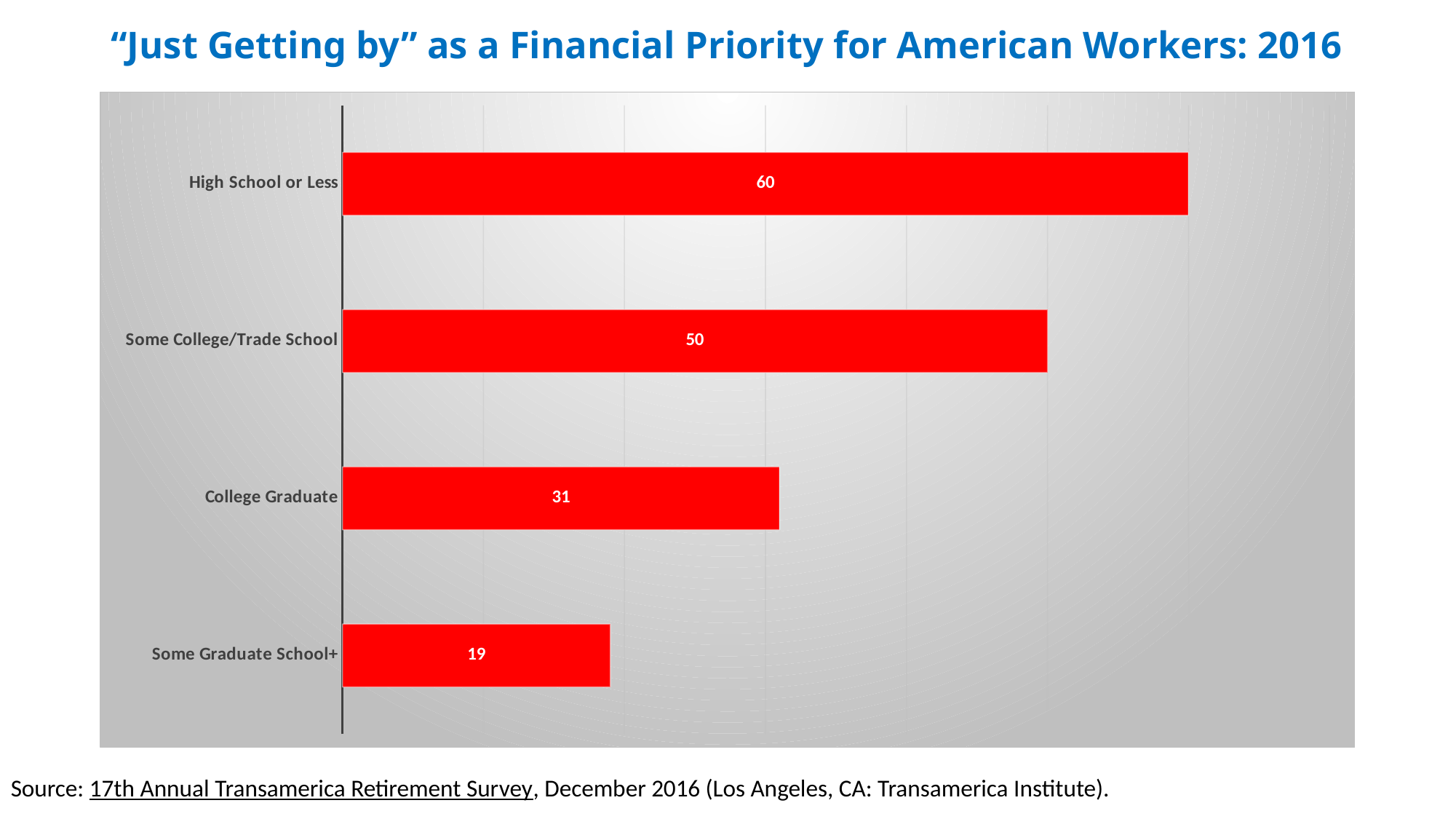
How many categories are shown in the chart? 4 What is the value for College Graduate? 31 What is the difference between the values for Some College/Trade School and College Graduate? 19 What is the value for Some College/Trade School? 50 What kind of chart is shown on the slide? Bar chart What is the difference between the values for High School or Less and Some Graduate School+? 41 Which is larger, the value for College Graduate or the value for Some College/Trade School? Some College/Trade School What is the value for Some Graduate School+? 19 Which category has the highest value? High School or Less What is the value for High School or Less? 60 Which category has the lowest value? Some Graduate School+ What is the title of the chart? "Just Getting by" as a Financial Priority for American Workers: 2016